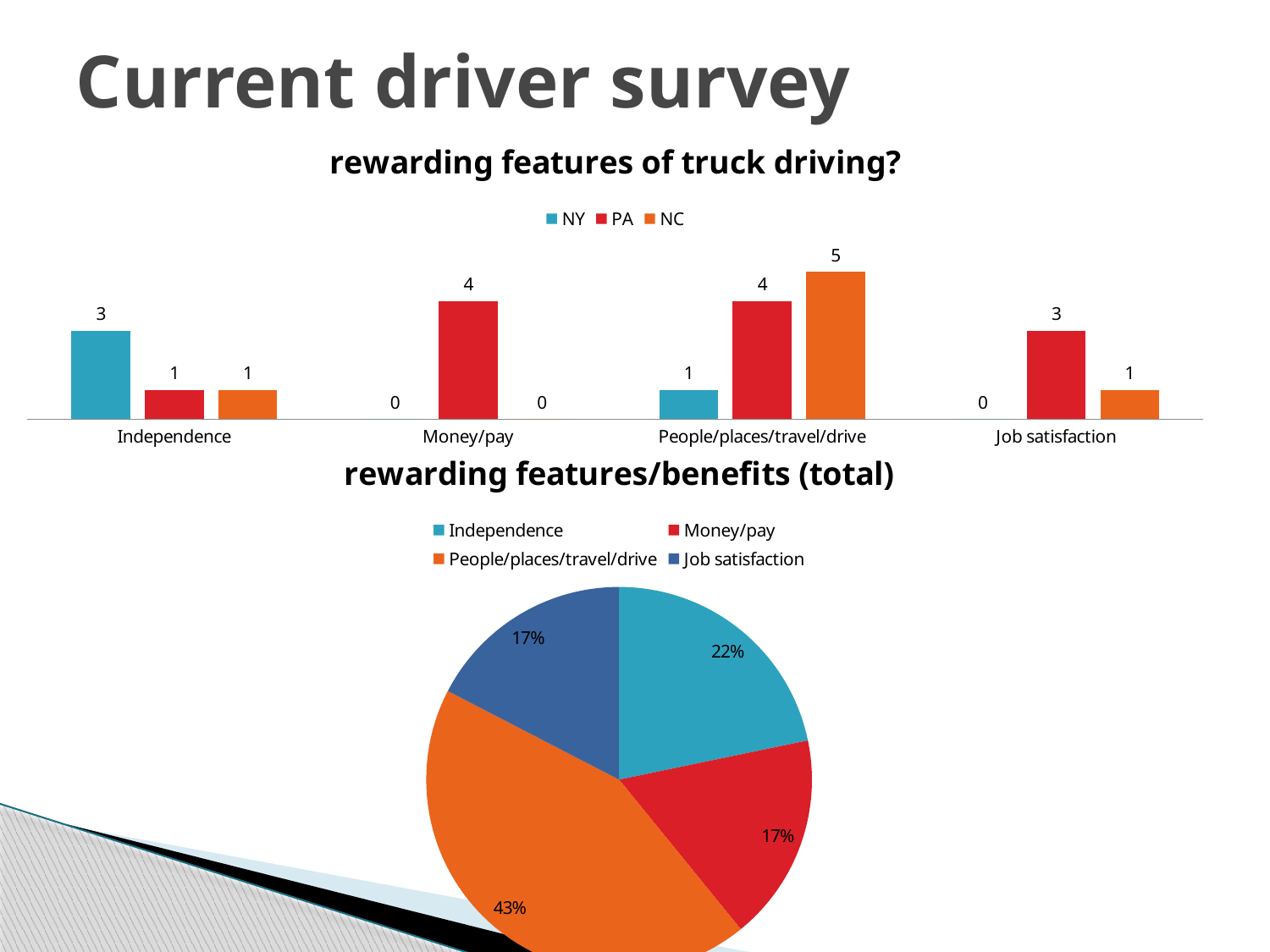
In the 'rewarding features/benefits (total)' pie chart, what share does Independence have? 22% In the 'rewarding features of truck driving?' chart, what is the PA value for Money/pay? 4 In the 'rewarding features of truck driving?' chart, which is larger for Job satisfaction: the PA value or the NC value? PA In the 'rewarding features of truck driving?' chart, what is the difference between the NC value and the NY value for People/places/travel/drive? 4 In the 'rewarding features of truck driving?' chart, what is the NY value for Independence? 3 In the 'rewarding features of truck driving?' chart, how many categories are shown on the x axis? 4 In the 'rewarding features of truck driving?' chart, which category has the highest PA value? Money/pay and People/places/travel/drive (both 4) In the 'rewarding features of truck driving?' chart, how many series does the legend list? 3 What kind of chart is the 'rewarding features of truck driving?' chart? Bar chart In the 'rewarding features of truck driving?' chart, what is the NC value for People/places/travel/drive? 5 In the 'rewarding features/benefits (total)' pie chart, which slice is the largest? People/places/travel/drive In the 'rewarding features/benefits (total)' pie chart, what share does People/places/travel/drive have? 43%